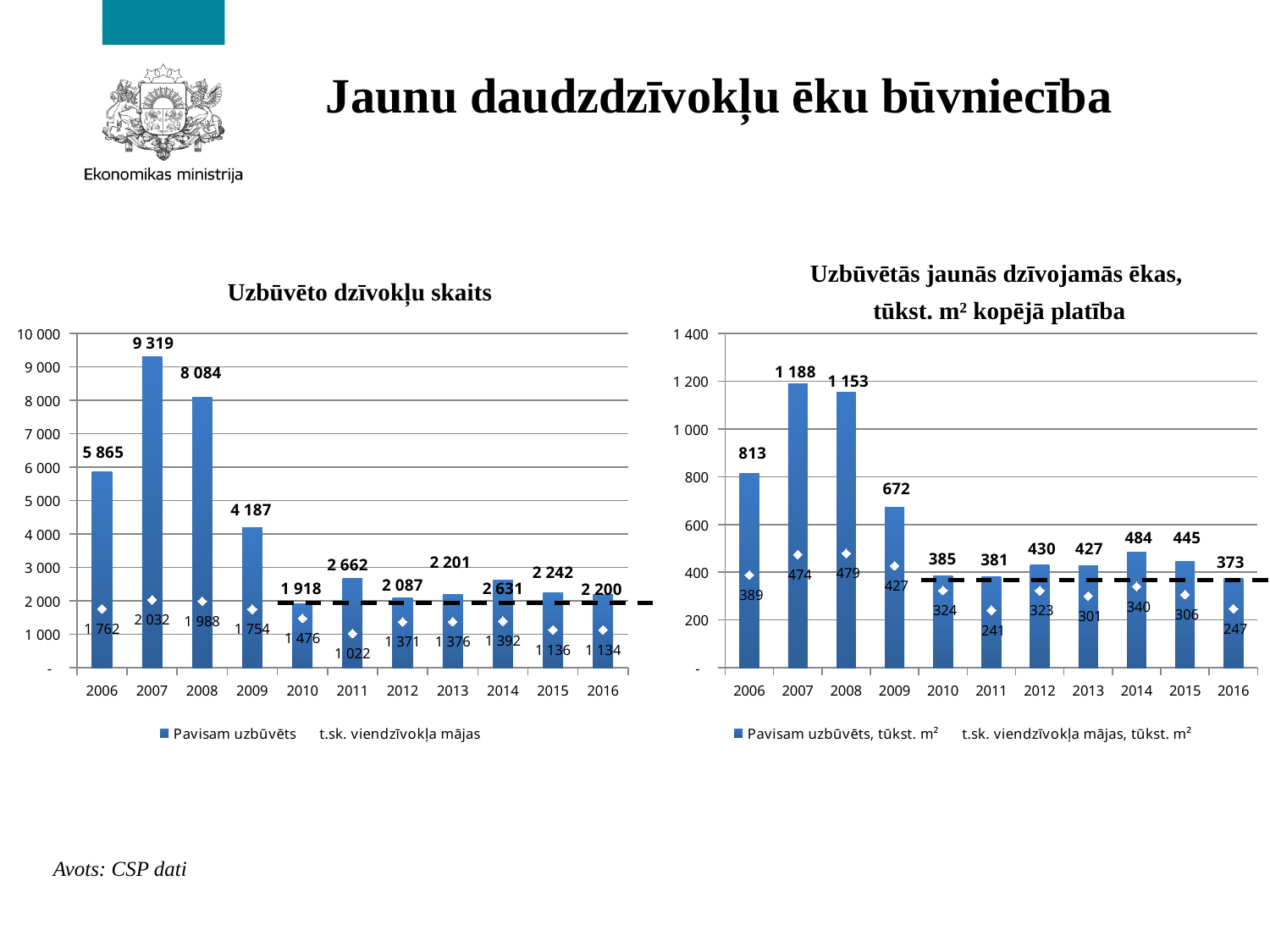
In the right-hand chart 'Uzbūvētās jaunās dzīvojamās ēkas, tūkst. m² kopējā platība', what is the value of 'Pavisam uzbūvēts, tūkst. m²' for 2014? 484 In the right-hand chart 'Uzbūvētās jaunās dzīvojamās ēkas, tūkst. m² kopējā platība', is the 'Pavisam uzbūvēts, tūkst. m²' value for 2006 larger or smaller than the value for 2009? larger In the chart 'Uzbūvēto dzīvokļu skaits', what is the difference between the 'Pavisam uzbūvēts' values for 2007 and 2008? 1 235 In the right-hand chart 'Uzbūvētās jaunās dzīvojamās ēkas, tūkst. m² kopējā platība', which year has the highest 'Pavisam uzbūvēts, tūkst. m²' value? 2007 In the chart 'Uzbūvēto dzīvokļu skaits', which year has the lowest 'Pavisam uzbūvēts' value? 2010 In the right-hand chart 'Uzbūvētās jaunās dzīvojamās ēkas, tūkst. m² kopējā platība', what is the value of 't.sk. viendzīvokļa mājas, tūkst. m²' for 2016? 247 In the chart 'Uzbūvēto dzīvokļu skaits', which year has the highest 'Pavisam uzbūvēts' value? 2007 What kind of chart is 'Uzbūvēto dzīvokļu skaits'? bar chart with a line/marker series In the chart 'Uzbūvēto dzīvokļu skaits', what is the value of 'Pavisam uzbūvēts' for 2007? 9 319 In the chart 'Uzbūvēto dzīvokļu skaits', how many series does the legend list? 2 In the chart 'Uzbūvēto dzīvokļu skaits', what is the value of 't.sk. viendzīvokļa mājas' for 2011? 1 022 In the chart 'Uzbūvēto dzīvokļu skaits', how many years are shown on the x axis? 11